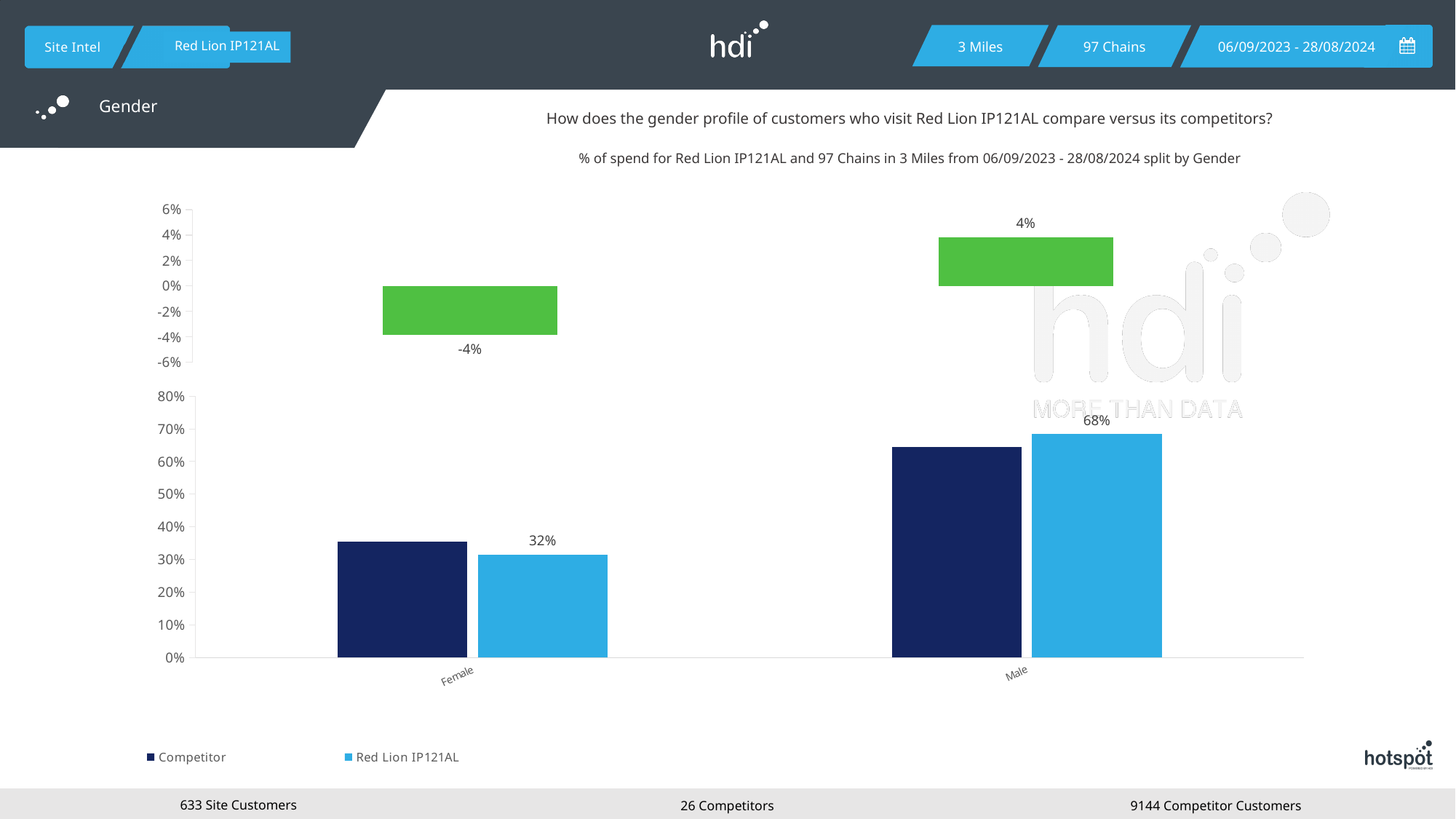
In the bottom bar chart, for Female, which is larger: the Competitor value or the Red Lion IP121AL value? Competitor In the bottom bar chart, which gender category has the higher value for Red Lion IP121AL? Male In the top chart showing the difference versus competitors, what is the value for Female? -4% In the bottom bar chart, for Male, which is larger: the Competitor value or the Red Lion IP121AL value? Red Lion IP121AL What type of chart is the bottom chart on the slide? Bar chart In the top chart showing the difference versus competitors, what is the value for Male? 4% In the bottom bar chart, what is the value for Red Lion IP121AL for Male? 68% In the bottom bar chart, is the Competitor value for Female greater or less than 40%? less In the bottom bar chart, what is the value for Red Lion IP121AL for Female? 32% In the bottom bar chart, what is the difference between the Red Lion IP121AL values for Male and Female? 36% How many series does the legend of the bottom bar chart list? 2 In the bottom bar chart, is the Competitor value for Male greater or less than 60%? greater